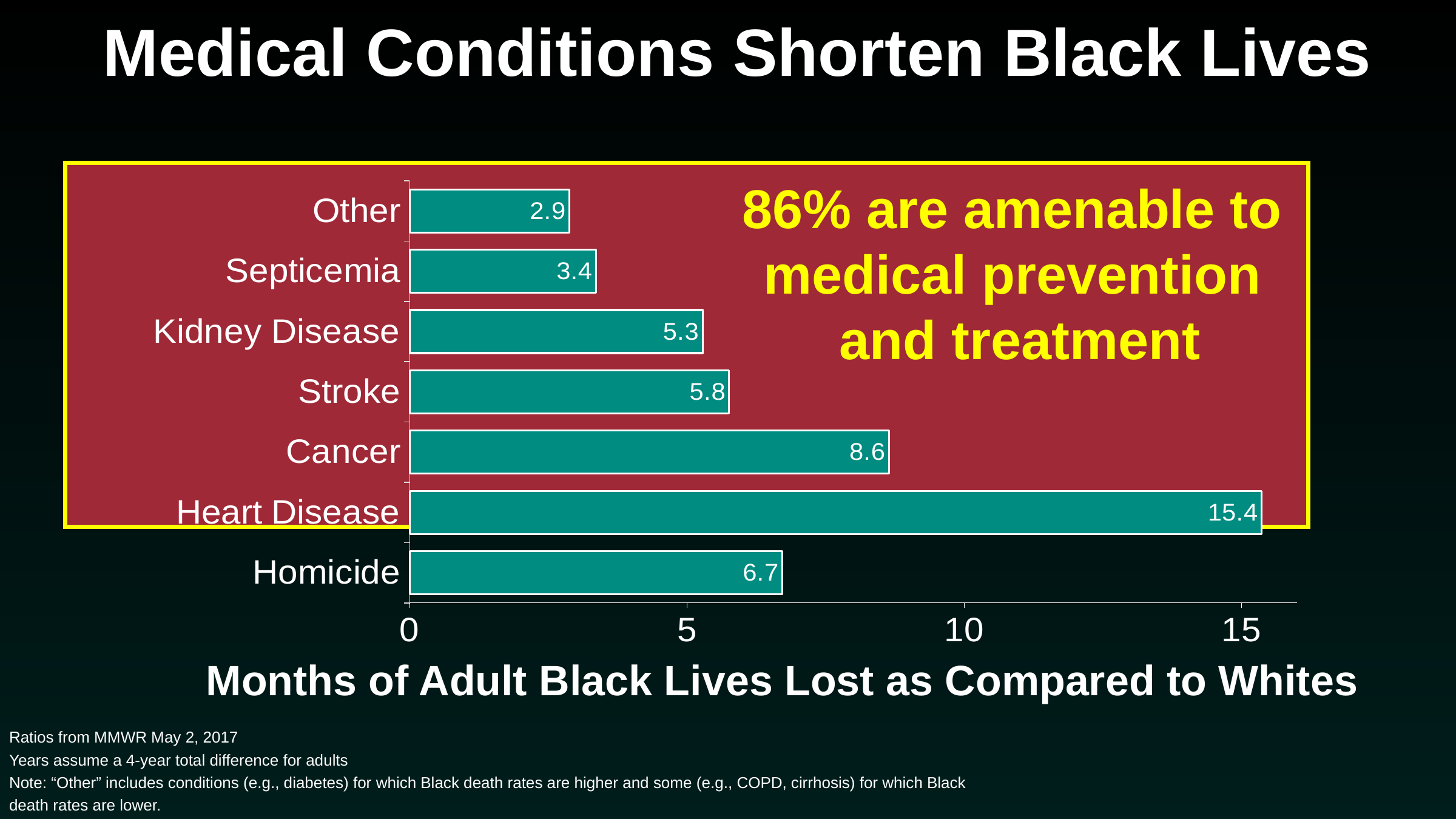
What is the value for Septicemia? 3.4 Which category has the lowest value? Other What is the x-axis label of the chart? Months of Adult Black Lives Lost as Compared to Whites How many categories are shown in the chart? 7 Which is larger, the value for Stroke or the value for Kidney Disease? Stroke What is the difference between the values for Homicide and Stroke? 0.9 What is the value for Heart Disease? 15.4 What is the value for Homicide? 6.7 What kind of chart is shown on the slide? bar chart Is the value for Cancer greater or less than 10? less What is the difference between the values for Heart Disease and Cancer? 6.8 Which category has the highest value? Heart Disease